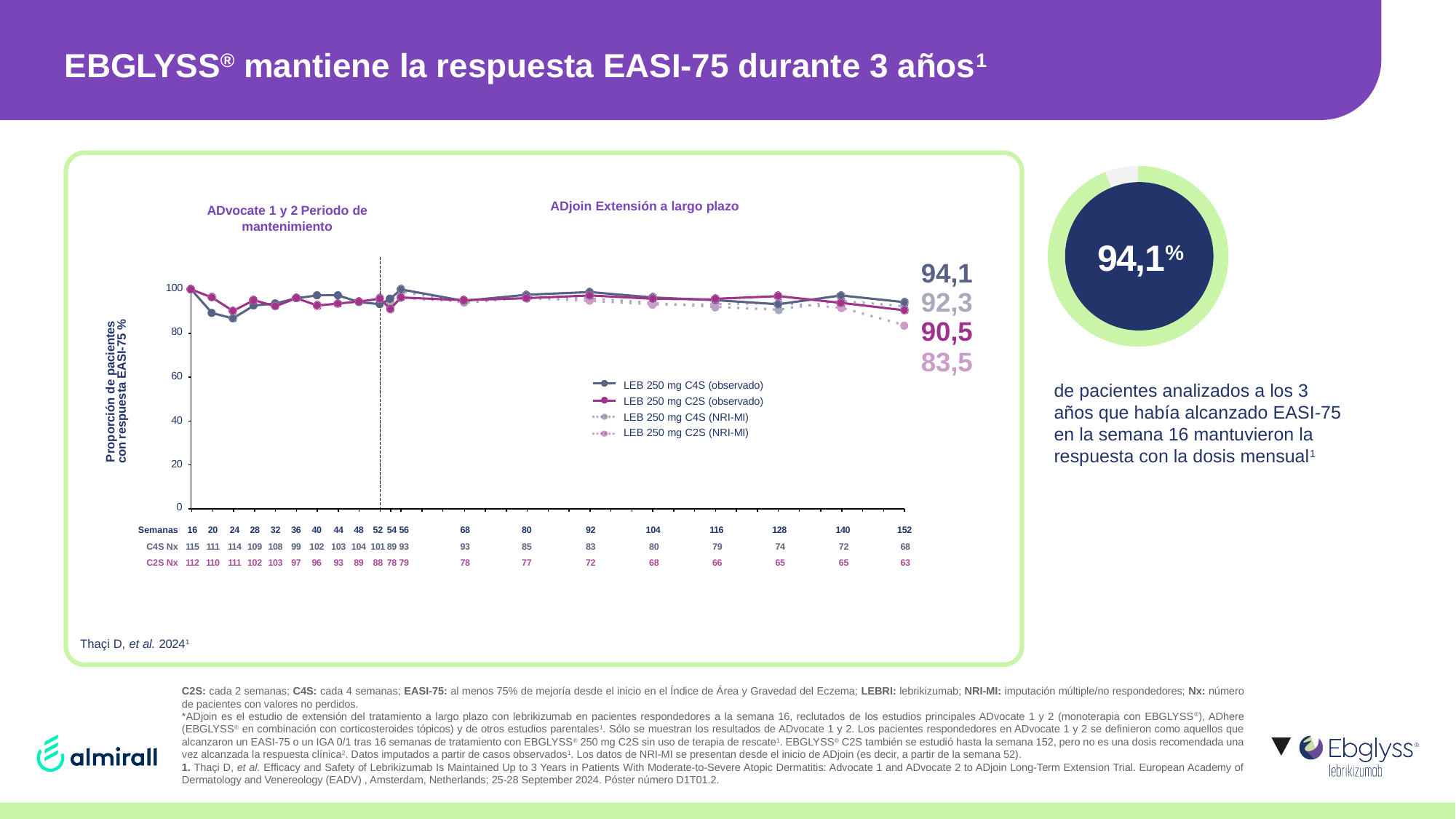
In the line chart, what is the value printed at week 152 for LEB 250 mg C2S (NRI-MI)? 83,5 In the line chart, which series has the lowest value at week 152? LEB 250 mg C2S (NRI-MI) In the line chart, what is the value printed at week 152 for LEB 250 mg C4S (observado)? 94,1 What is the label of the y axis of the line chart? Proporción de pacientes con respuesta EASI-75 % In the line chart, at week 152, which is larger: LEB 250 mg C4S (observado) or LEB 250 mg C2S (observado)? LEB 250 mg C4S (observado) What percentage is shown in the centre of the doughnut chart on the right of the slide? 94,1% In the line chart, is the value for LEB 250 mg C4S (observado) at week 24 greater or less than 80? greater In the line chart, what is the difference between the week 152 values for LEB 250 mg C4S (observado) and LEB 250 mg C2S (NRI-MI)? 10,6 What kind of chart is the large chart on the left of the slide? line chart In the line chart, what is the value printed at week 152 for LEB 250 mg C2S (observado)? 90,5 How many series does the legend of the line chart list? 4 In the line chart, what is the difference between the week 152 values for LEB 250 mg C4S (NRI-MI) and LEB 250 mg C2S (observado)? 1,8